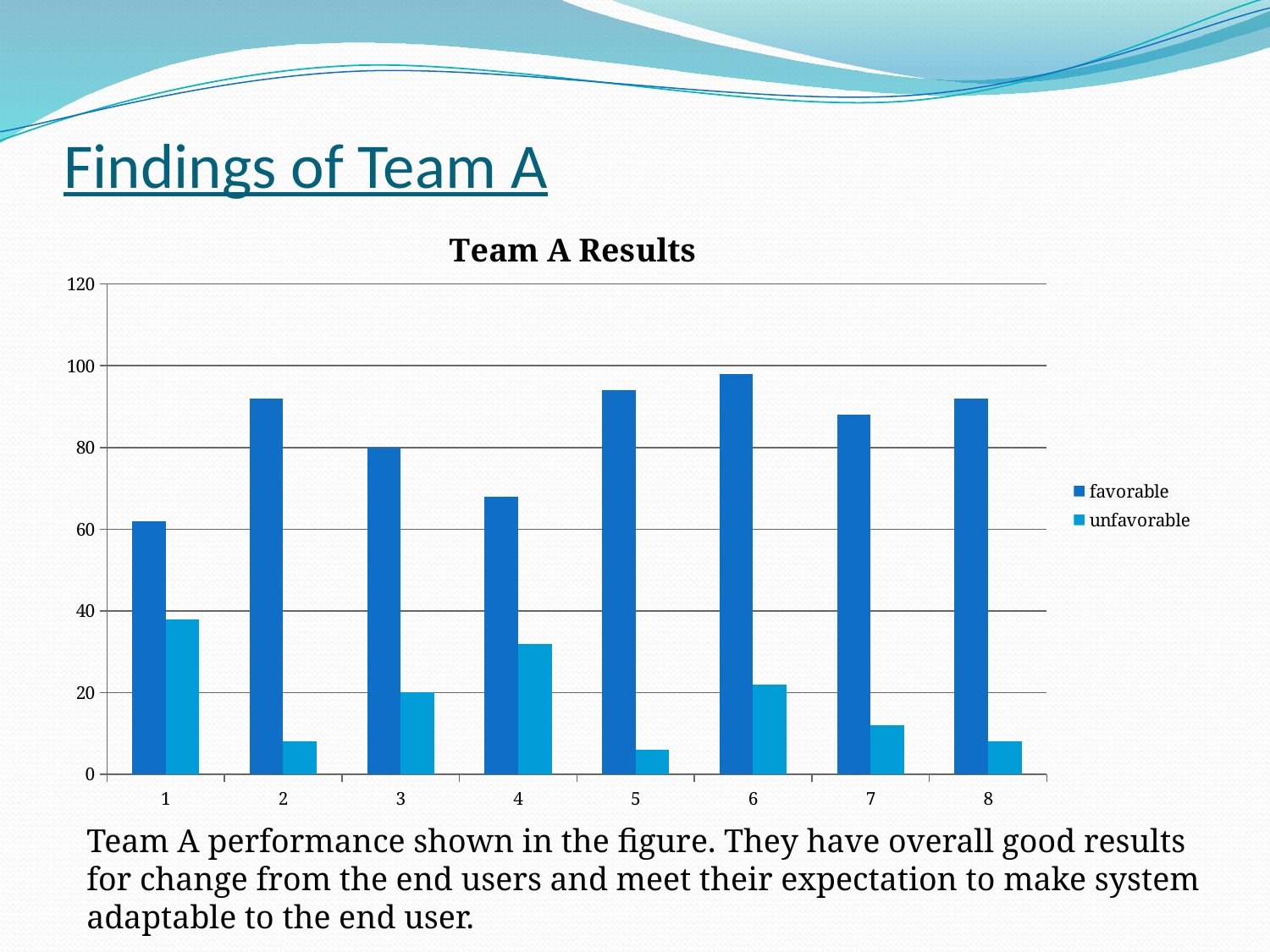
What type of chart is shown on the slide? bar chart Which category has the highest unfavorable value? 1 What is the favorable value for category 3? 80 What is the title of the chart? Team A Results For category 5, which is larger, the favorable or the unfavorable value? favorable Is the favorable value for category 1 greater or less than 80? less How many categories are shown on the x axis? 8 Is the favorable value for category 2 greater or less than 80? greater Is the unfavorable value for category 4 greater or less than 20? greater How many series does the legend list? 2 Which category has the highest favorable value? 6 Which category has the lowest favorable value? 1